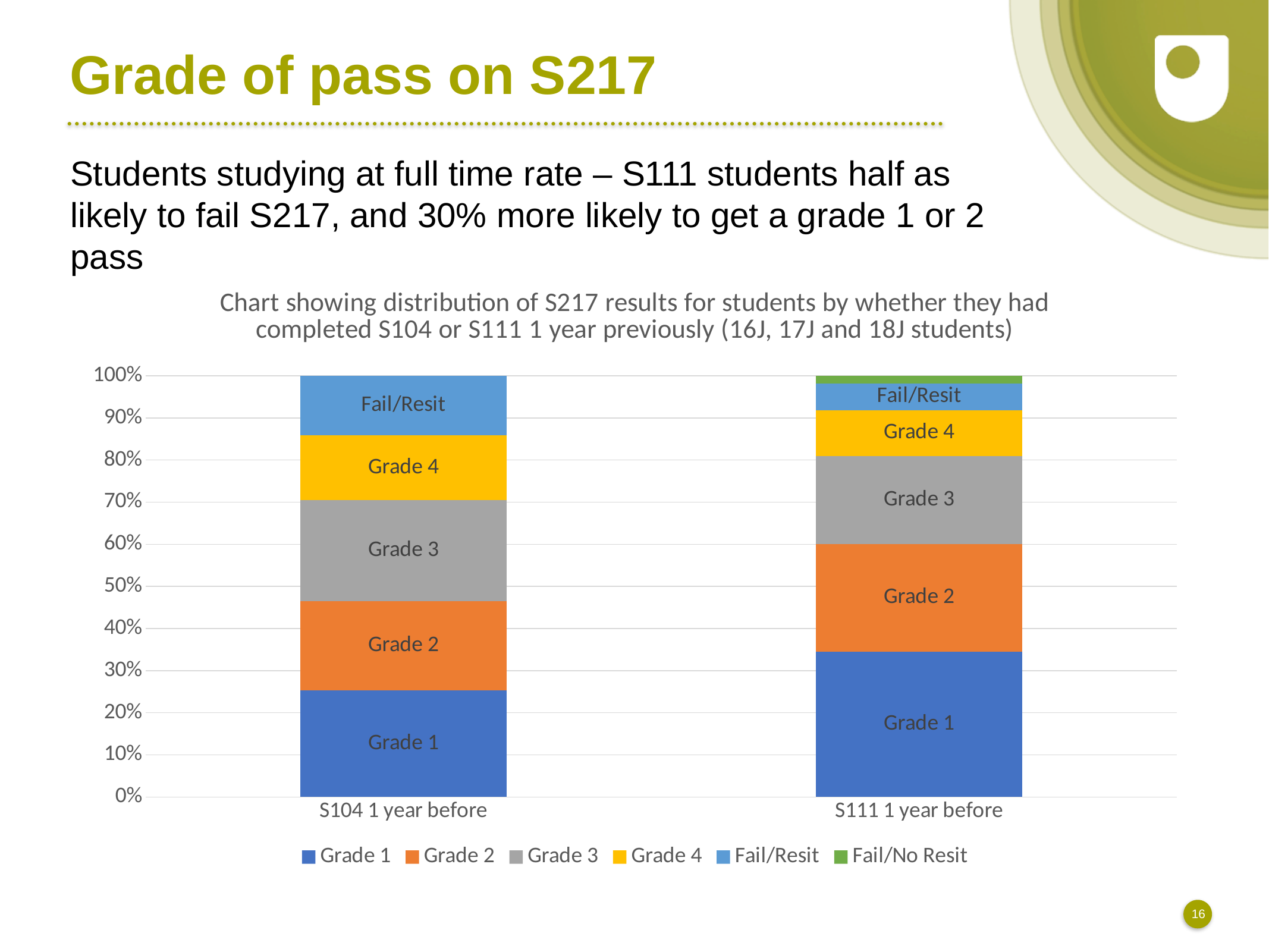
How many series does the chart's legend list? 6 What kind of chart is shown on the slide? Stacked bar chart What colour represents Grade 4 in the chart's legend? Yellow Which series forms the largest segment of the 'S111 1 year before' bar? Grade 1 How many categories are shown on the x axis of the chart? 2 What is the total height of each stacked bar in the chart? 100% Is the Grade 1 share for 'S104 1 year before' greater or less than 30%? less Which category has the larger Grade 1 share, 'S104 1 year before' or 'S111 1 year before'? S111 1 year before Which category has the larger Fail/Resit share, 'S104 1 year before' or 'S111 1 year before'? S104 1 year before Is the Grade 1 share for 'S111 1 year before' greater or less than 30%? greater Which series appears only in the 'S111 1 year before' bar and not in the 'S104 1 year before' bar? Fail/No Resit Which series forms the smallest segment of the 'S111 1 year before' bar? Fail/No Resit